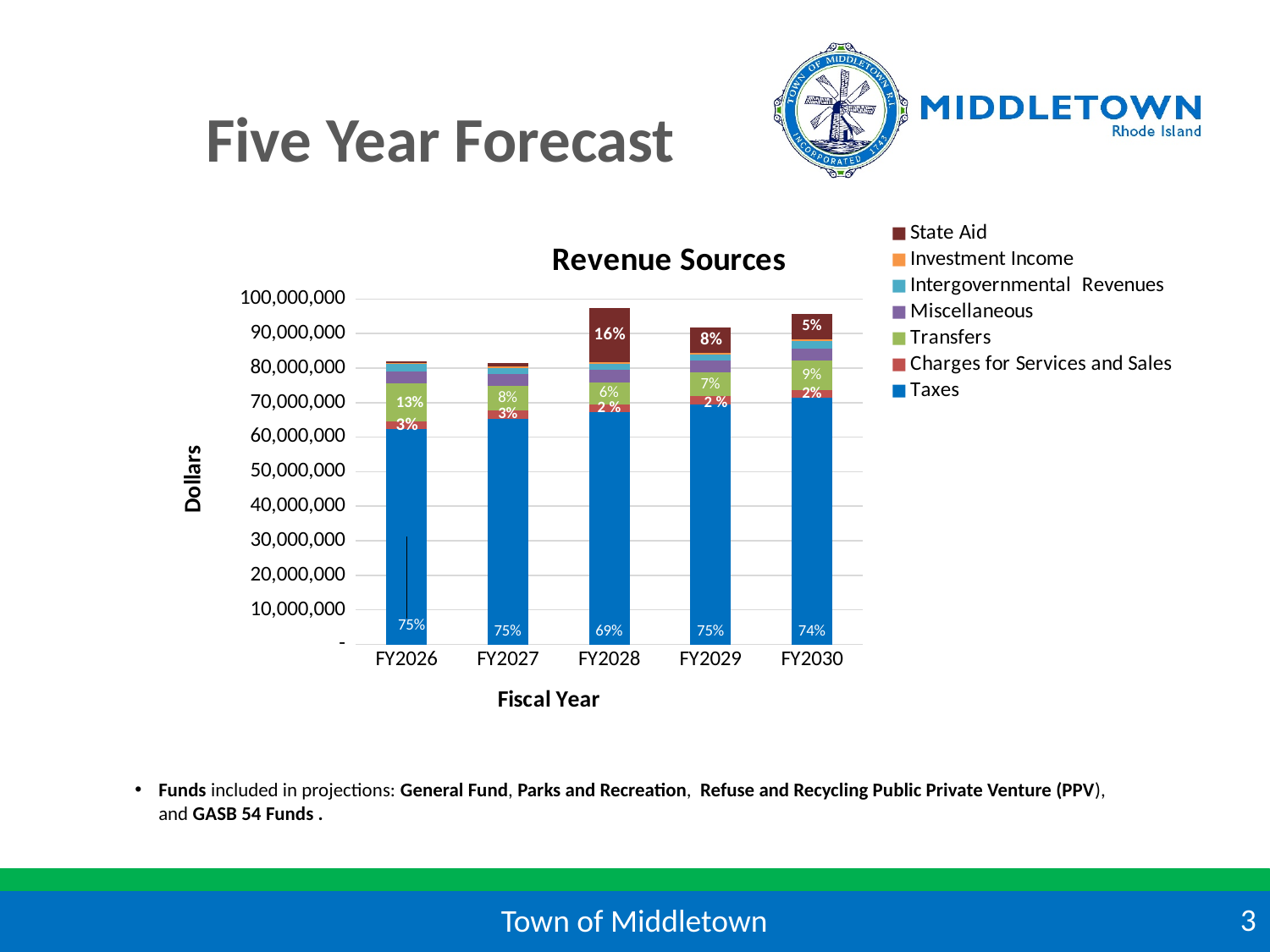
Which fiscal year has the tallest total revenue bar? FY2028 How many fiscal years are shown on the x axis? 5 What percentage label is shown for Taxes in FY2028? 69% What percentage label is shown for State Aid in FY2028? 16% What is the title of the chart? Revenue Sources Is the total revenue bar for FY2028 greater or less than 90,000,000? greater What percentage label is shown for State Aid in FY2030? 5% How many series does the legend list? 7 Which is larger, the Taxes percentage in FY2026 or in FY2028? FY2026 By how many percentage points does the State Aid share in FY2028 exceed that in FY2029? 8 percentage points What type of chart is shown on the slide? Stacked bar chart What percentage label is shown for Transfers in FY2026? 13%